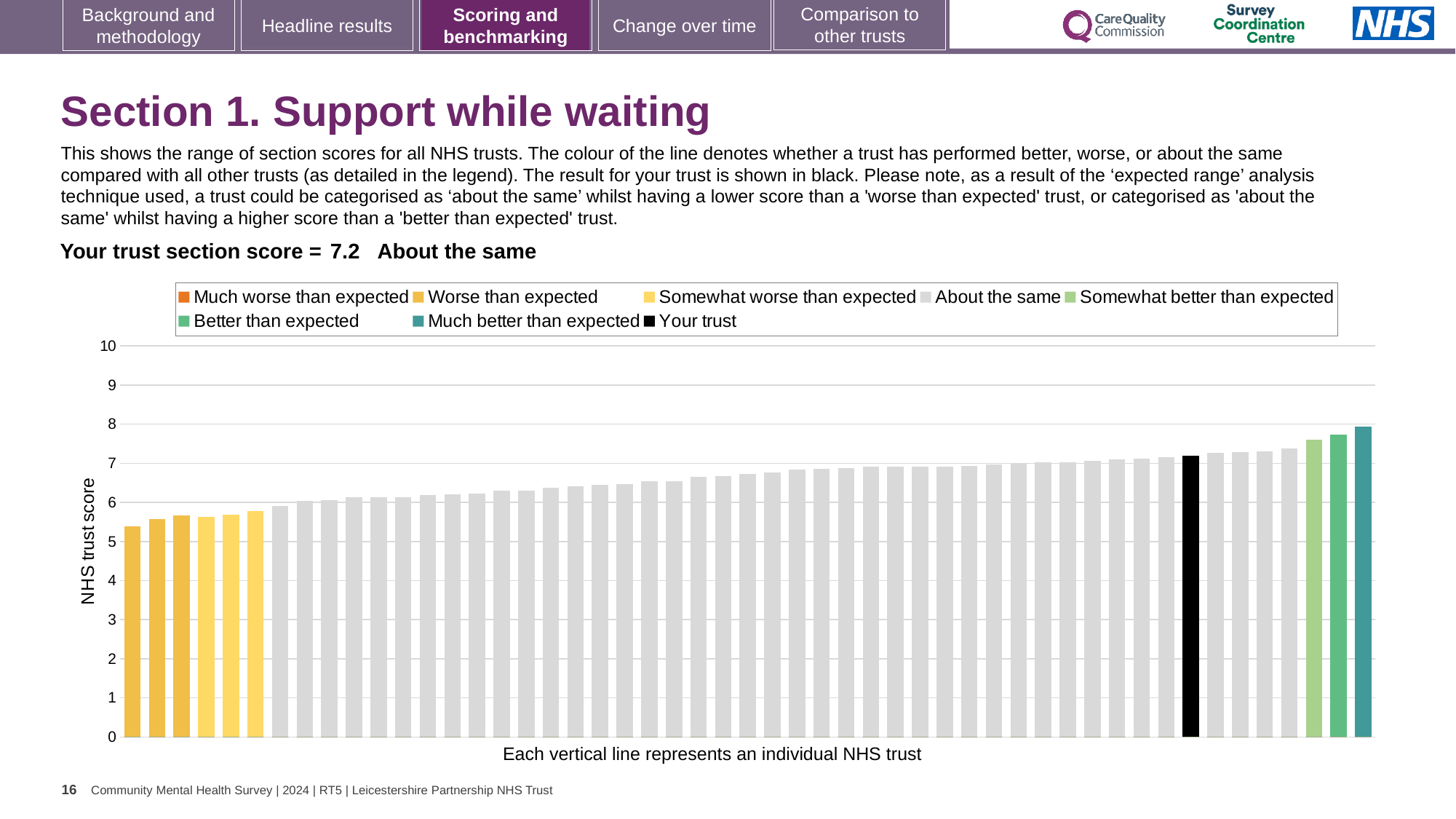
How many entries does the chart legend list? 8 What is the label on the vertical axis of the chart? NHS trust score What is the section score for your trust shown on the slide? 7.2 Is the value of the lowest bar in the chart greater or less than 5? greater What kind of chart is shown on the slide? bar chart What colour is used for the bar representing your trust? black Which is larger: the value for your trust (black bar) or the value of the rightmost bar? the rightmost bar Do the bar values rise or fall from left to right along the x axis? rise Which performance category is your trust placed in for this section? About the same Is the value of the lowest bar in the chart greater or less than 6? less Is the value for your trust (the black bar) greater or less than 7? greater